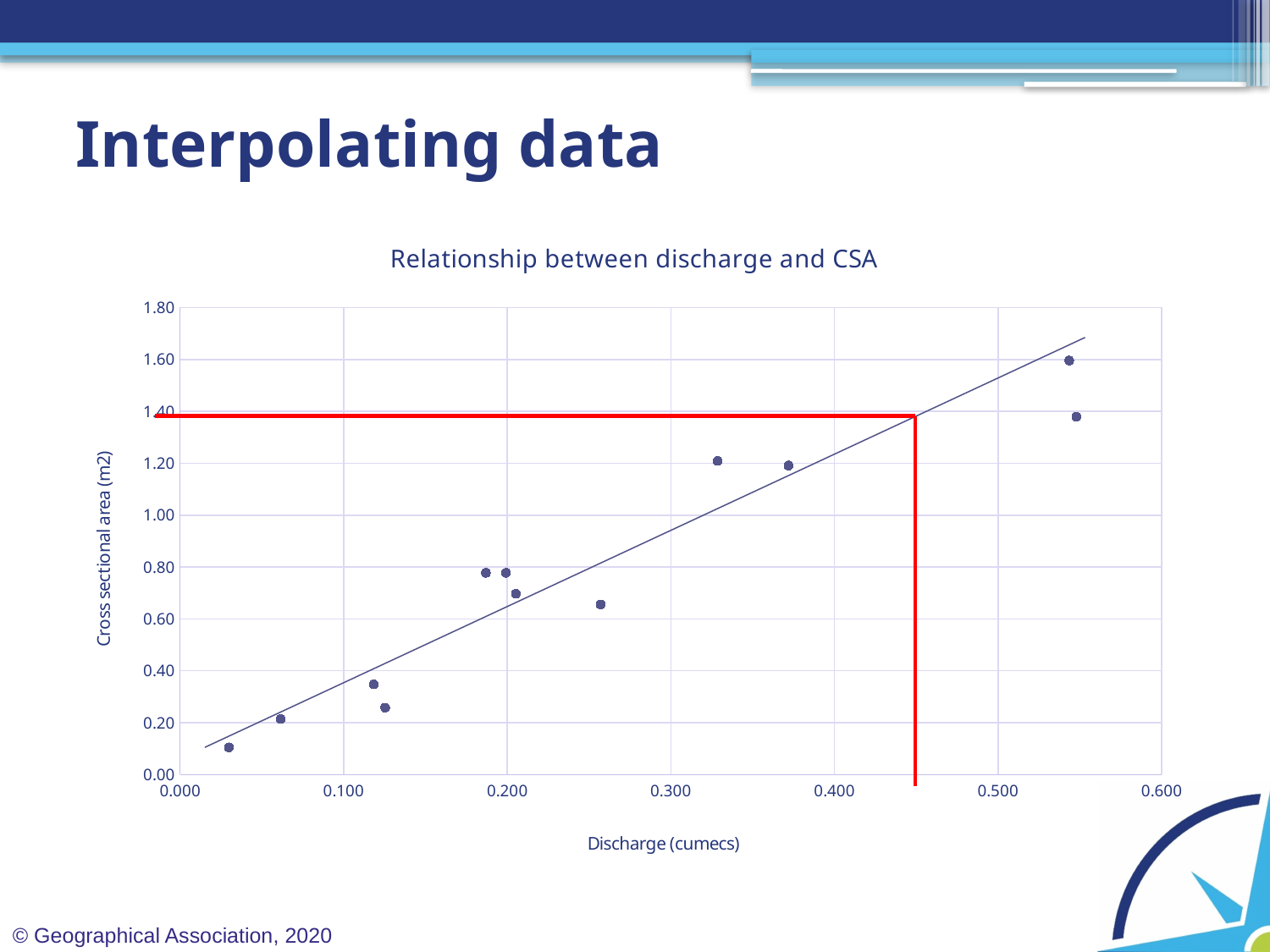
Is the cross sectional area of the lowest plotted point greater or less than 0.20? less What kind of chart is shown on the slide? scatter chart Do the cross sectional area values generally rise or fall as discharge increases along the x axis? rise What is the highest value shown on the vertical axis of the chart? 1.80 Is the cross sectional area of the highest plotted point greater or less than 1.40? greater Is the cross sectional area of the point plotted at a discharge of about 0.255 cumecs greater or less than 0.80? less What is the highest value shown on the horizontal axis of the chart? 0.600 What is the label of the vertical axis of the chart? Cross sectional area (m2) What is the title of the chart? Relationship between discharge and CSA How many data points are plotted on the chart? 12 What cross sectional area value on the y axis does the red horizontal line mark? 1.40